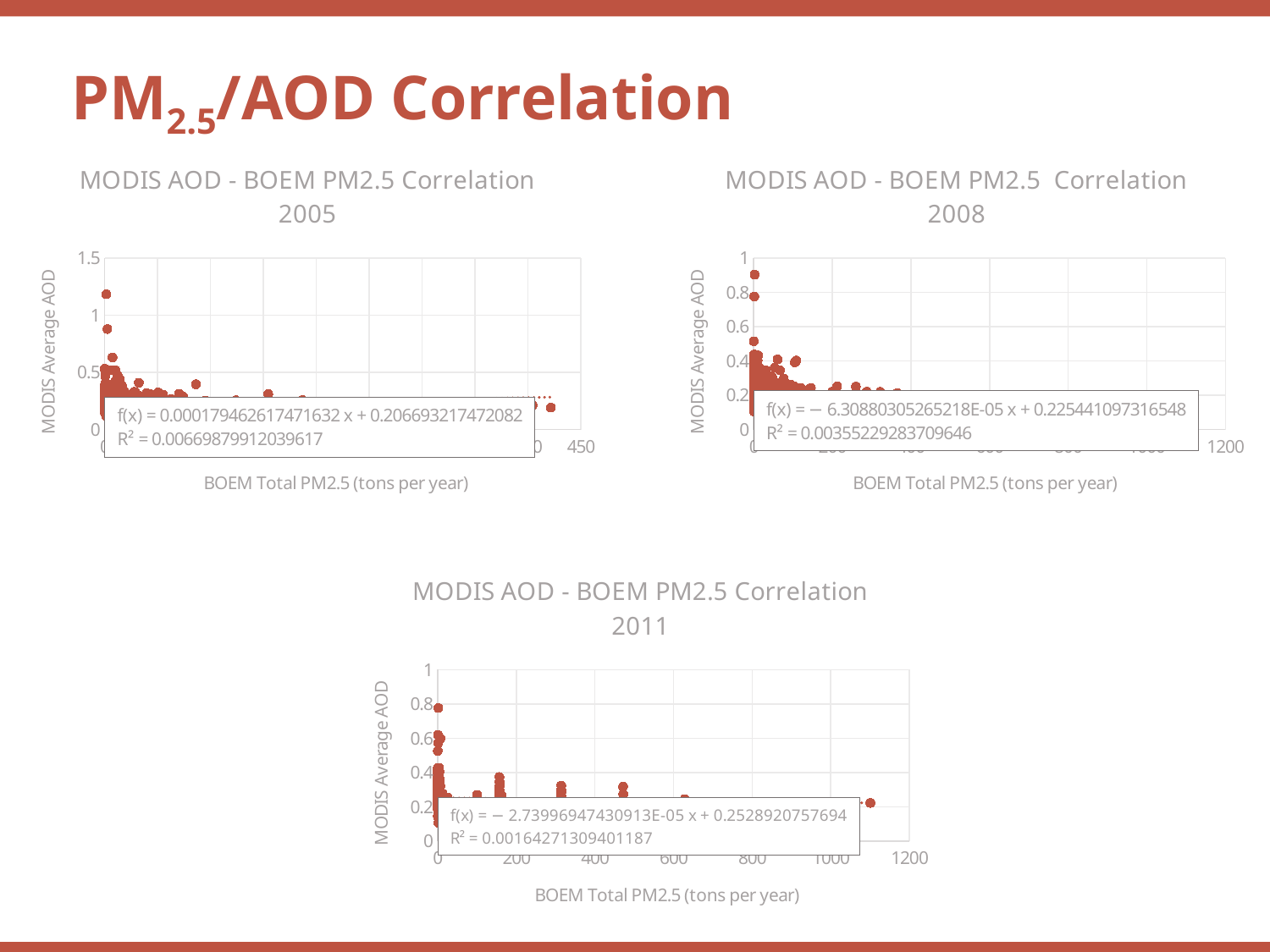
In the 'MODIS AOD - BOEM PM2.5 Correlation 2008' chart, what is the R² value printed on the chart? 0.00355229283709646 In the 'MODIS AOD - BOEM PM2.5 Correlation 2005' chart, does the fitted trendline slope upward or downward as BOEM Total PM2.5 increases? Upward In the 'MODIS AOD - BOEM PM2.5 Correlation 2005' chart, is the highest MODIS Average AOD point greater or less than 1? greater Which of the three charts has the highest R² value? MODIS AOD - BOEM PM2.5 Correlation 2005 Which of the three charts has the lowest R² value? MODIS AOD - BOEM PM2.5 Correlation 2011 What kind of chart is the 'MODIS AOD - BOEM PM2.5 Correlation 2005' chart? Scatter plot In the 'MODIS AOD - BOEM PM2.5 Correlation 2008' chart, does the fitted trendline slope upward or downward as BOEM Total PM2.5 increases? Downward What is the x-axis title of the 'MODIS AOD - BOEM PM2.5 Correlation 2011' chart? BOEM Total PM2.5 (tons per year) How many charts are shown on the slide? 3 In the 'MODIS AOD - BOEM PM2.5 Correlation 2011' chart, what is the R² value printed on the chart? 0.00164271309401187 In the 'MODIS AOD - BOEM PM2.5 Correlation 2005' chart, what is the R² value printed on the chart? 0.00669879912039617 In the 'MODIS AOD - BOEM PM2.5 Correlation 2008' chart, is the highest MODIS Average AOD point greater or less than 0.8? greater